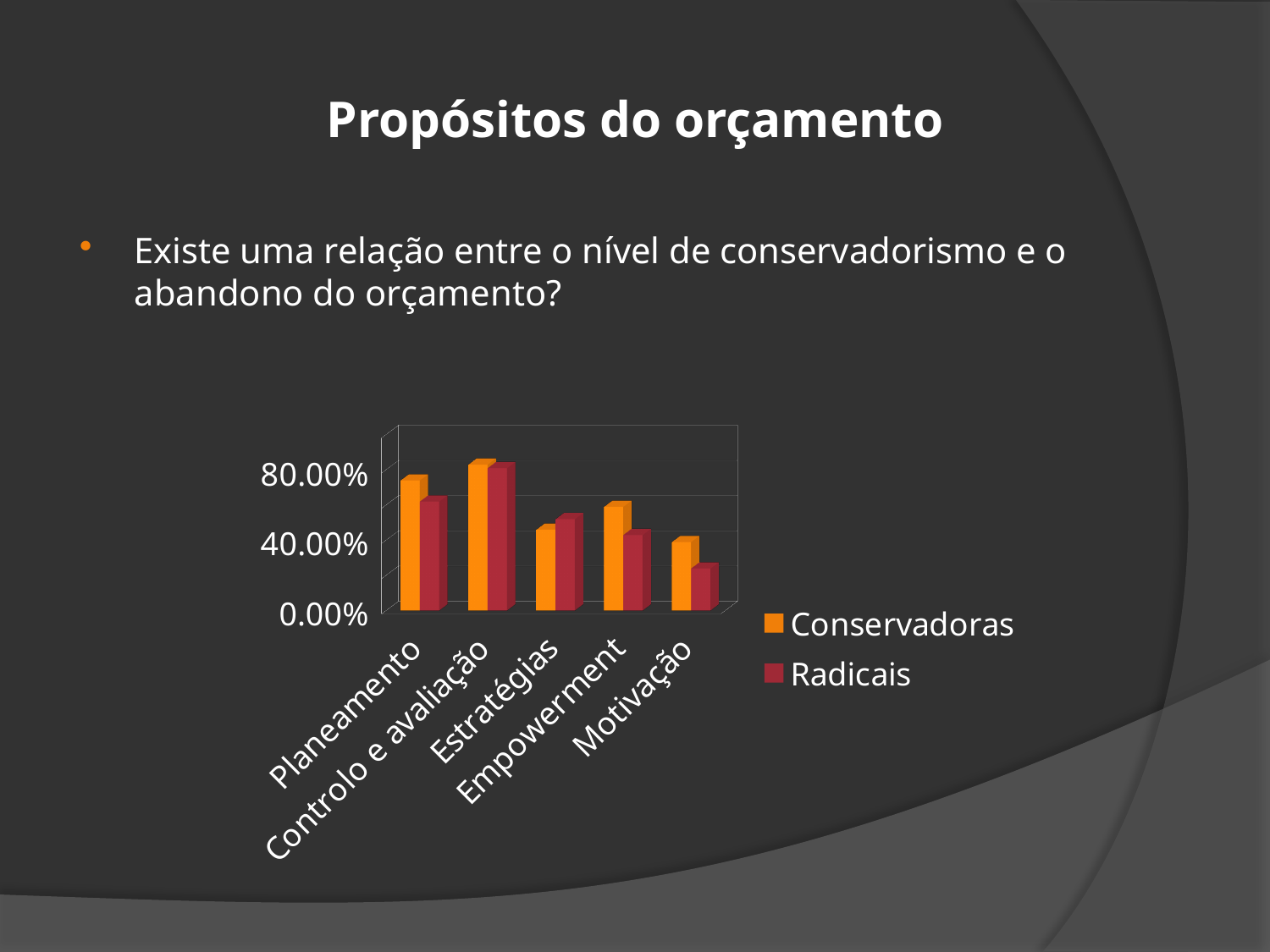
How many series does the chart legend list? 2 For Planeamento, which series has the larger value, Conservadoras or Radicais? Conservadoras For which category is the Radicais value highest? Controlo e avaliação For which category is the Conservadoras value highest? Controlo e avaliação Which series is shown in orange in the chart? Conservadoras For which category is the Radicais value lowest? Motivação Is the Conservadoras value for Planeamento greater or less than 40.00%? greater What kind of chart is shown on the slide? bar chart For Empowerment, which series has the larger value, Conservadoras or Radicais? Conservadoras Is the Radicais value for Motivação greater or less than 40.00%? less For Estratégias, which series has the larger value, Conservadoras or Radicais? Radicais How many categories are shown on the x axis of the chart? 5